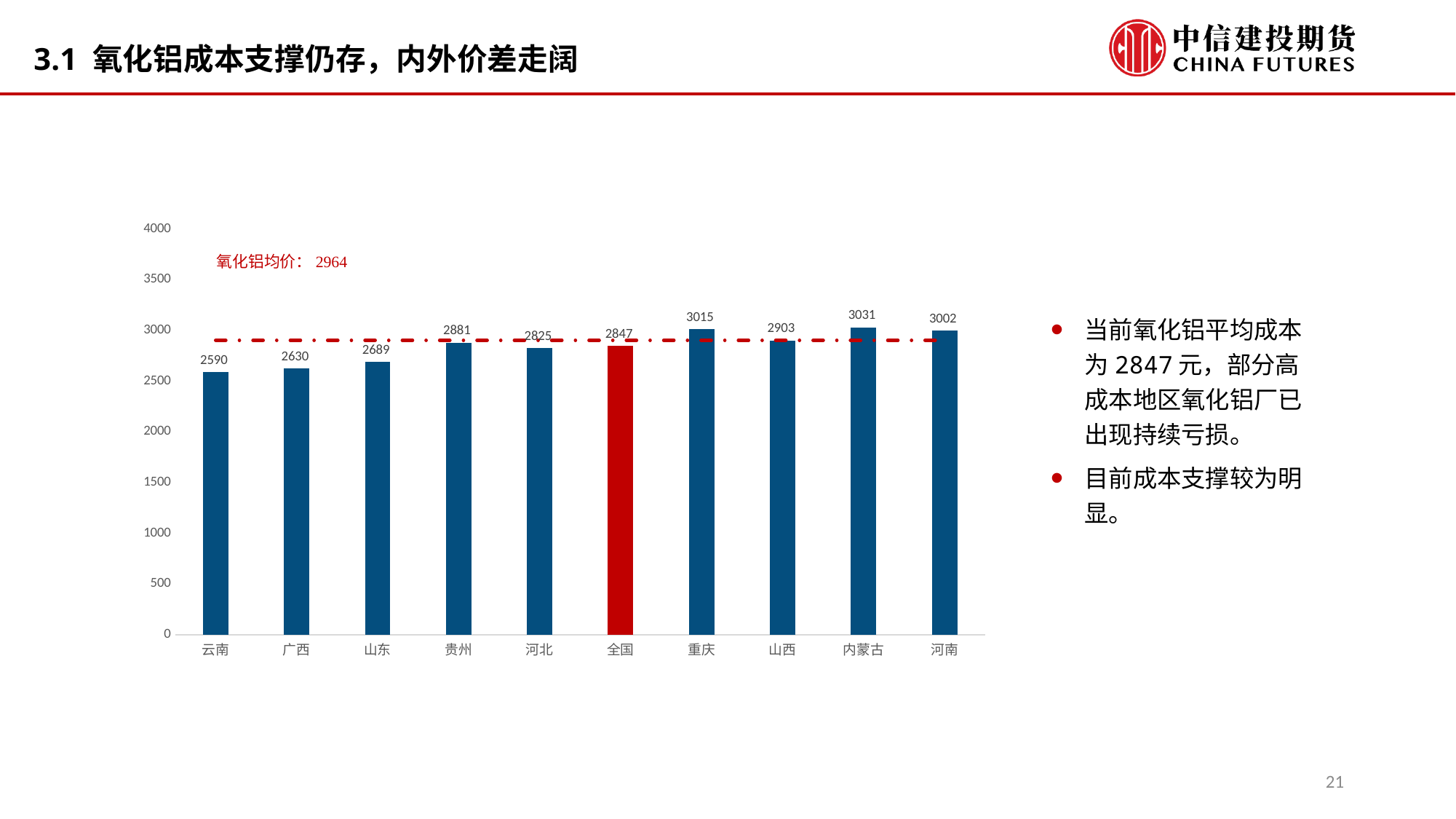
What is the value for 云南? 2590 Is the value for 山东 greater or less than 3000? less What is the difference between the values for 重庆 and 河南? 13 What is the difference between the values for 全国 and 云南? 257 How many categories are shown on the x axis? 10 Which category has the highest value? 内蒙古 Which is larger, the value for 贵州 or the value for 河北? 贵州 What kind of chart is shown on the slide? bar chart What is the value for 全国? 2847 Which category has the lowest value? 云南 What is the value for 内蒙古? 3031